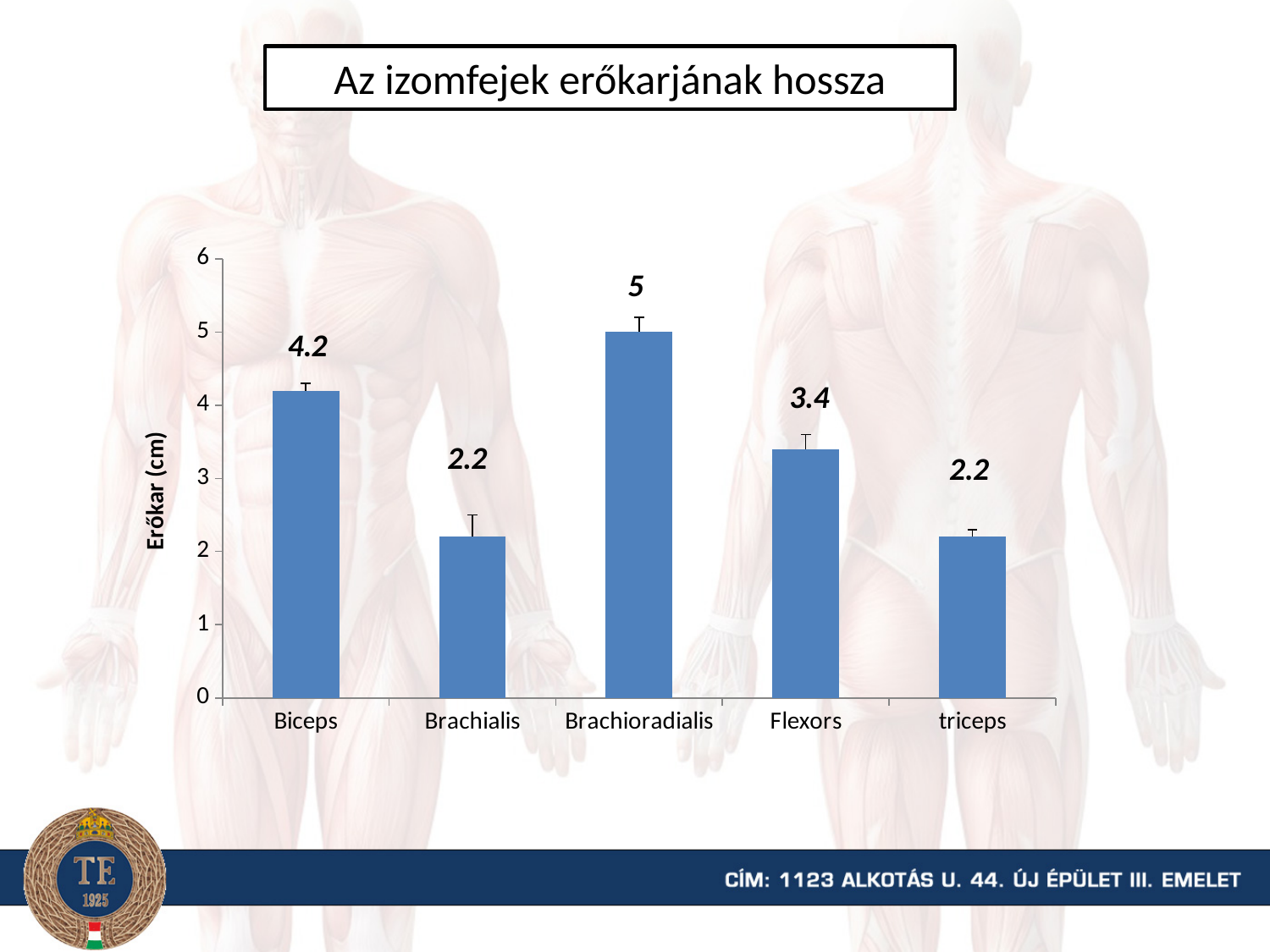
Which category has the highest value? Brachioradialis What is the value for Flexors? 3.4 What is the value for triceps? 2.2 What is the value for Brachioradialis? 5 What kind of chart is shown on the slide? bar chart Which is larger, the value for Biceps or the value for Flexors? Biceps How many categories are shown on the x axis? 5 What is the difference between the values for Brachioradialis and Biceps? 0.8 What is the difference between the values for Flexors and Brachialis? 1.2 Is the value for Brachialis greater or less than 3? less What is the label of the vertical axis? Erőkar (cm) What is the value for Biceps? 4.2